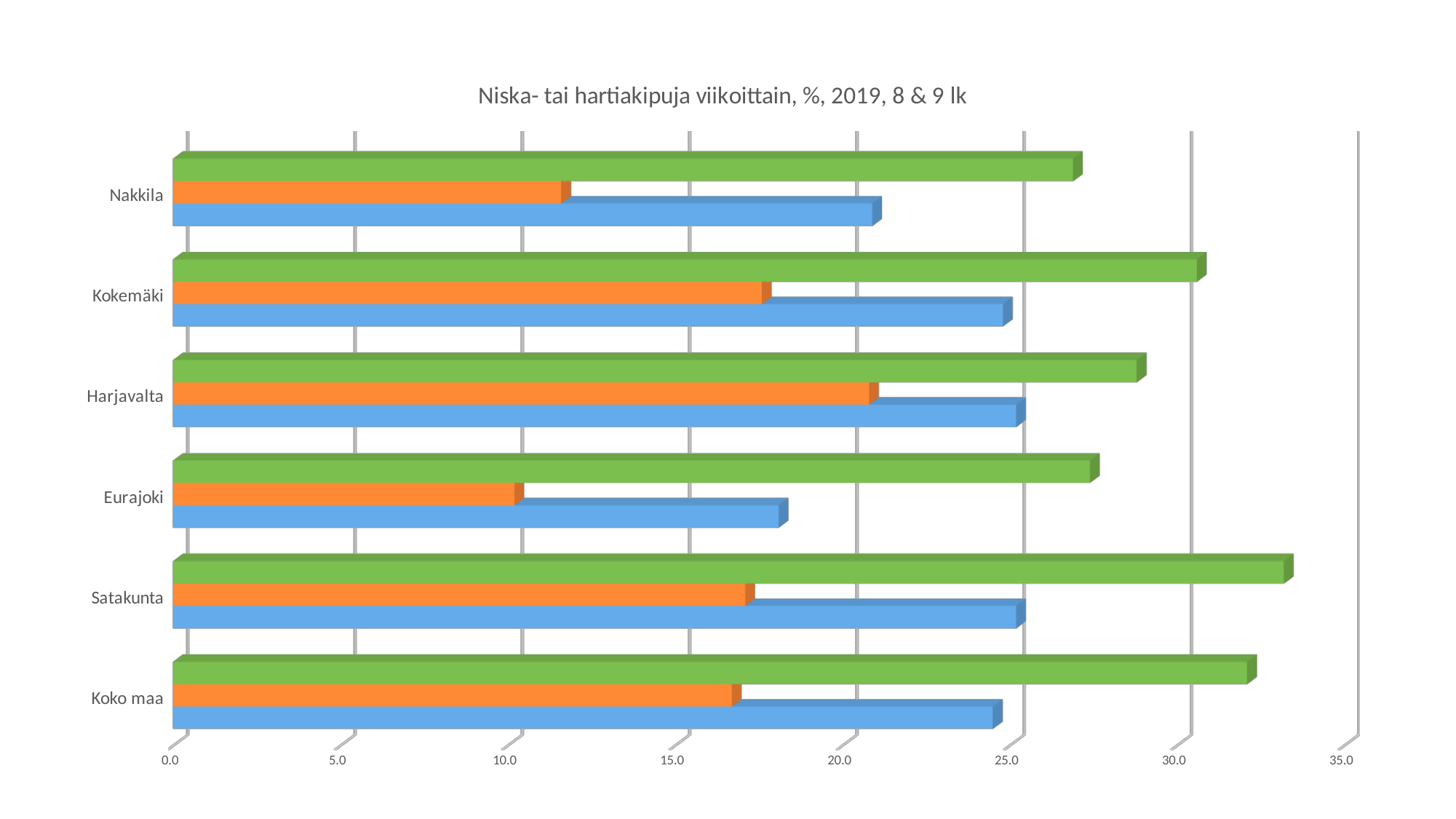
Which category has the longest green bar? Satakunta Which category has the shortest blue bar? Eurajoki Is the blue bar for Eurajoki greater or less than 20.0? less How many bars are shown for each category in the chart? 3 What is the title of the chart? Niska- tai hartiakipuja viikoittain, %, 2019, 8 & 9 lk What kind of chart is shown on the slide? bar chart Is the orange bar for Kokemäki greater or less than 20.0? less Which is larger, the green bar for Kokemäki or the green bar for Harjavalta? Kokemäki Is the green bar for Satakunta greater or less than 30.0? greater Which category has the shortest orange bar? Eurajoki How many categories are shown on the vertical axis of the chart? 6 Which category has the longest orange bar? Harjavalta